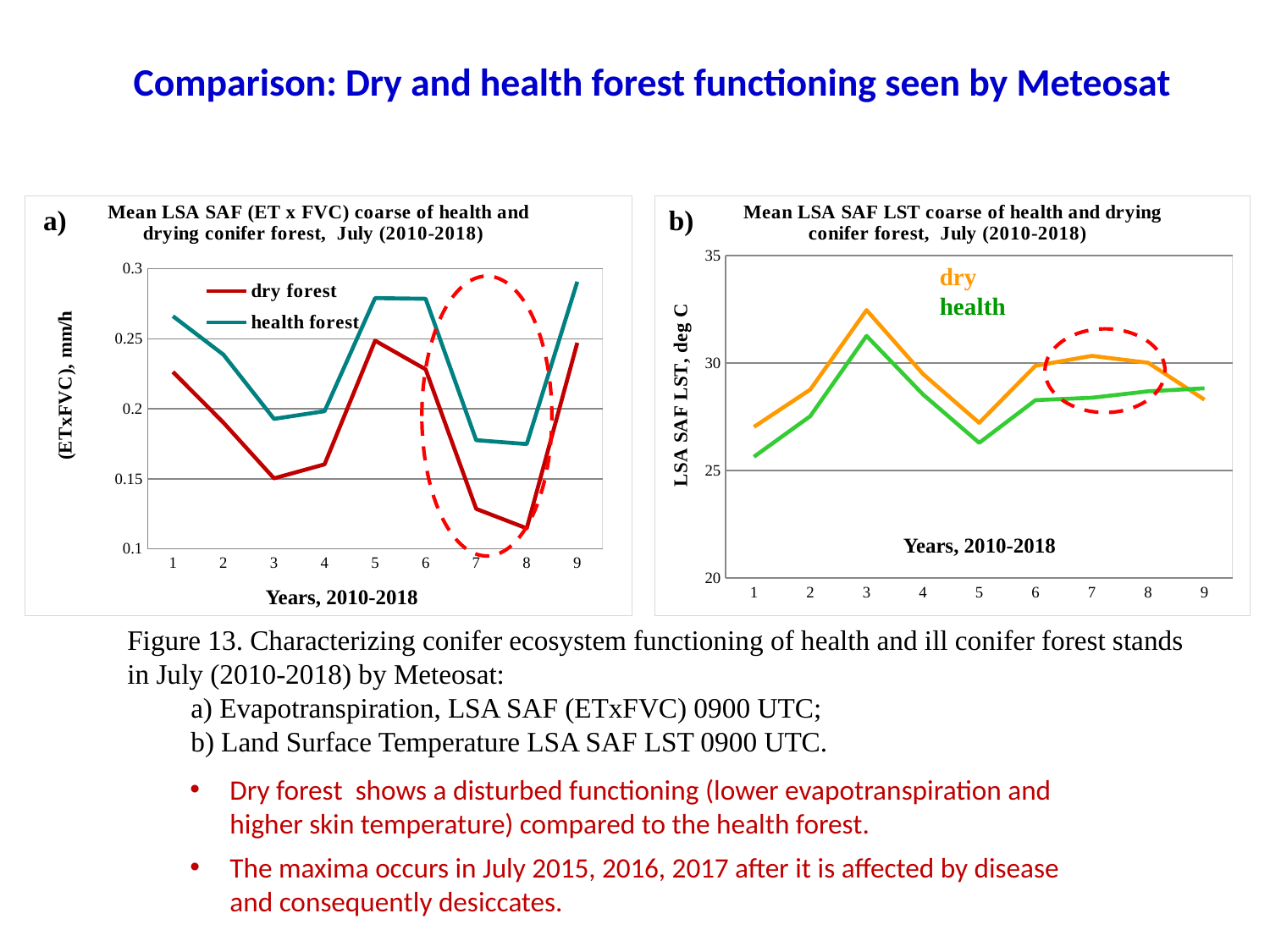
In chart a) on the left, how many series does the legend list? 2 In chart b) on the right, what is the label of the y axis? LSA SAF LST, deg C In chart b) on the right, at year 7, which series has the higher value, dry or health? dry In chart a) on the left, at year 7, which series has the higher value, dry forest or health forest? health forest In chart b) on the right, is the dry value at year 3 greater or less than 30? greater In chart a) on the left, does the dry forest series rise or fall from year 5 to year 8? fall In chart a) on the left, is the health forest value at year 9 greater or less than 0.25? greater In chart b) on the right, at which year does the dry series reach its highest value? 3 In chart a) on the left, how many points are plotted along the x axis for each series? 9 What type of chart is chart a) on the left? line chart In chart a) on the left, at which year does the dry forest series reach its lowest value? 8 In chart a) on the left, is the dry forest value at year 8 greater or less than 0.15? less